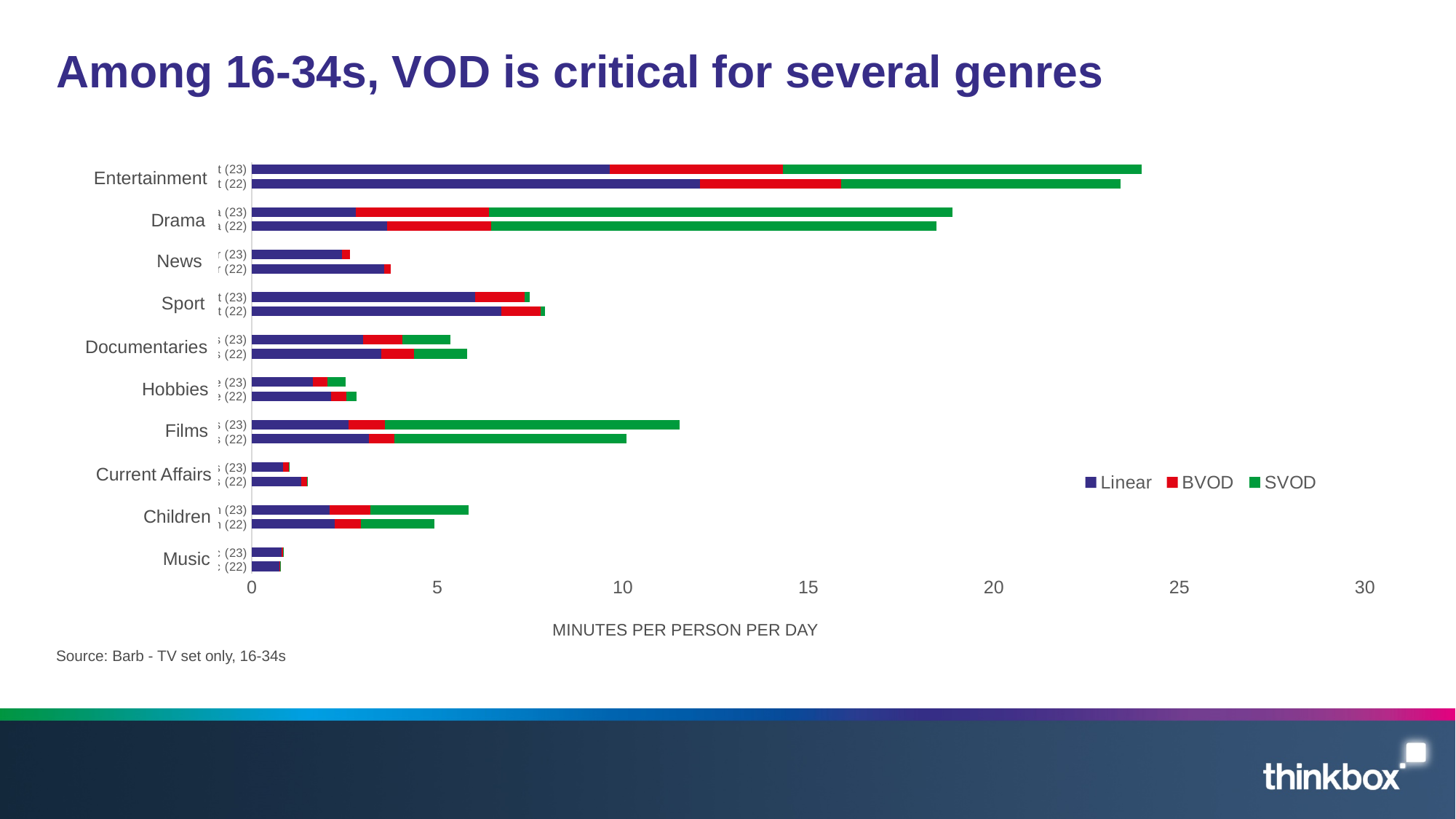
Is the total value for the Films (23) bar greater or less than 10? greater Is the total value for the Entertainment (23) bar greater or less than 20? greater What is the title of the horizontal axis? MINUTES PER PERSON PER DAY Which has a longer total bar, Drama (23) or Films (23)? Drama (23) What kind of chart is shown on the slide? Bar chart Which has a longer total bar, Films (23) or Sport (23)? Films (23) How many series does the legend list? 3 Is the total value for the News (23) bar greater or less than 5? less How many genres are shown on the chart? 10 Which genre has the longest bars on the chart? Entertainment Which genre has the shortest bars on the chart? Music